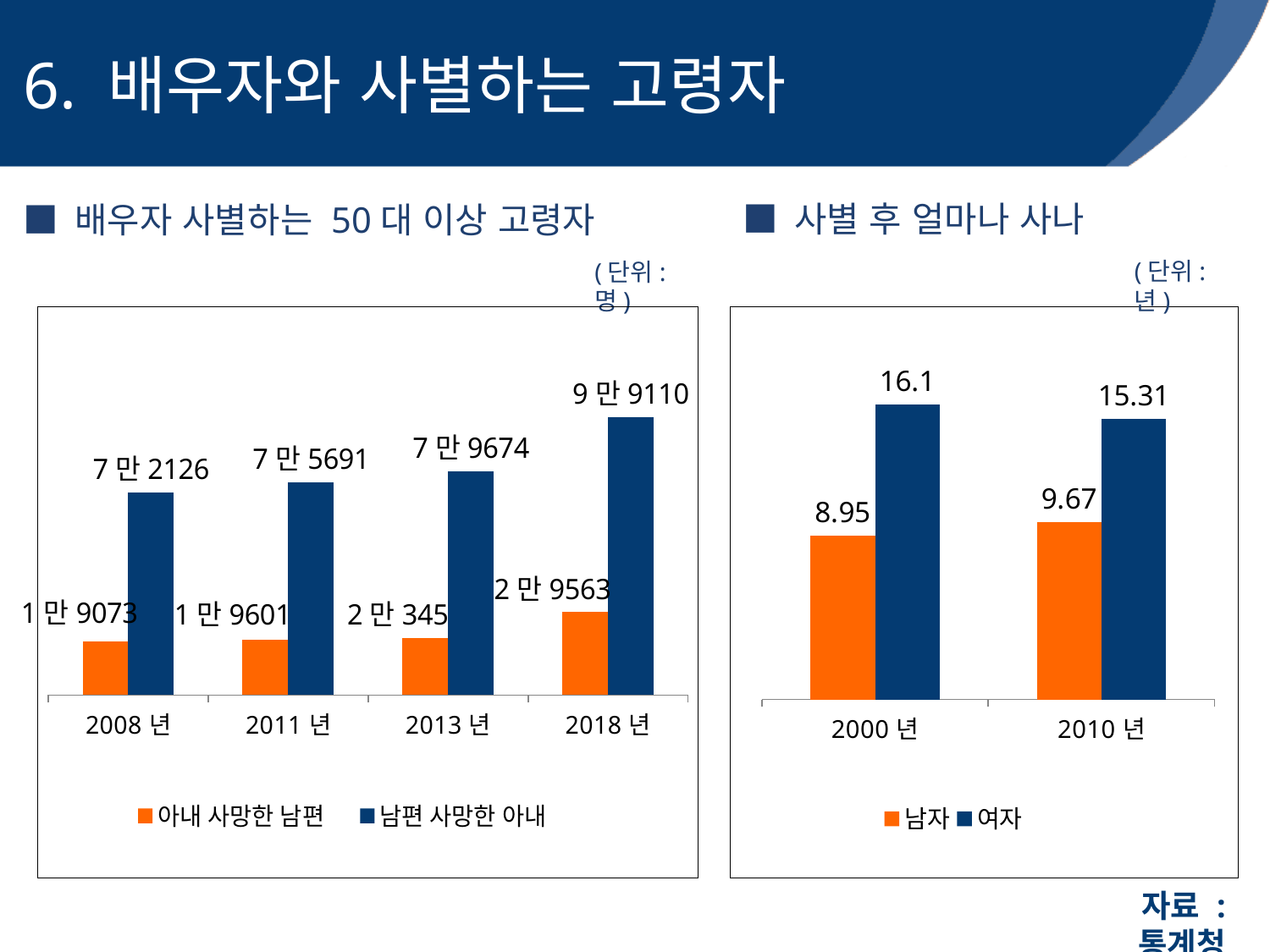
In the left chart (배우자 사별하는 50대 이상 고령자), which year has the highest value for 아내 사망한 남편? 2018 년 In the left chart (배우자 사별하는 50대 이상 고령자), what is the value for 남편 사망한 아내 in 2013 년? 7 만 9674 In the right chart (사별 후 얼마나 사나), what is the value for 여자 in 2000 년? 16.1 In the right chart (사별 후 얼마나 사나), which is larger in 2010 년, 남자 or 여자? 여자 In the right chart (사별 후 얼마나 사나), what is the difference between 여자 and 남자 in 2000 년? 7.15 In the left chart (배우자 사별하는 50대 이상 고령자), how many years are shown on the x axis? 4 In the left chart (배우자 사별하는 50대 이상 고령자), do the values for 남편 사망한 아내 rise or fall from 2008 년 to 2018 년? rise In the right chart (사별 후 얼마나 사나), what is the value for 남자 in 2010 년? 9.67 In the left chart (배우자 사별하는 50대 이상 고령자), which year has the lowest value for 남편 사망한 아내? 2008 년 In the right chart (사별 후 얼마나 사나), how many series does the legend list? 2 In the left chart (배우자 사별하는 50대 이상 고령자), what is the value for 남편 사망한 아내 in 2018 년? 9 만 9110 In the left chart (배우자 사별하는 50대 이상 고령자), what is the value for 아내 사망한 남편 in 2008 년? 1 만 9073